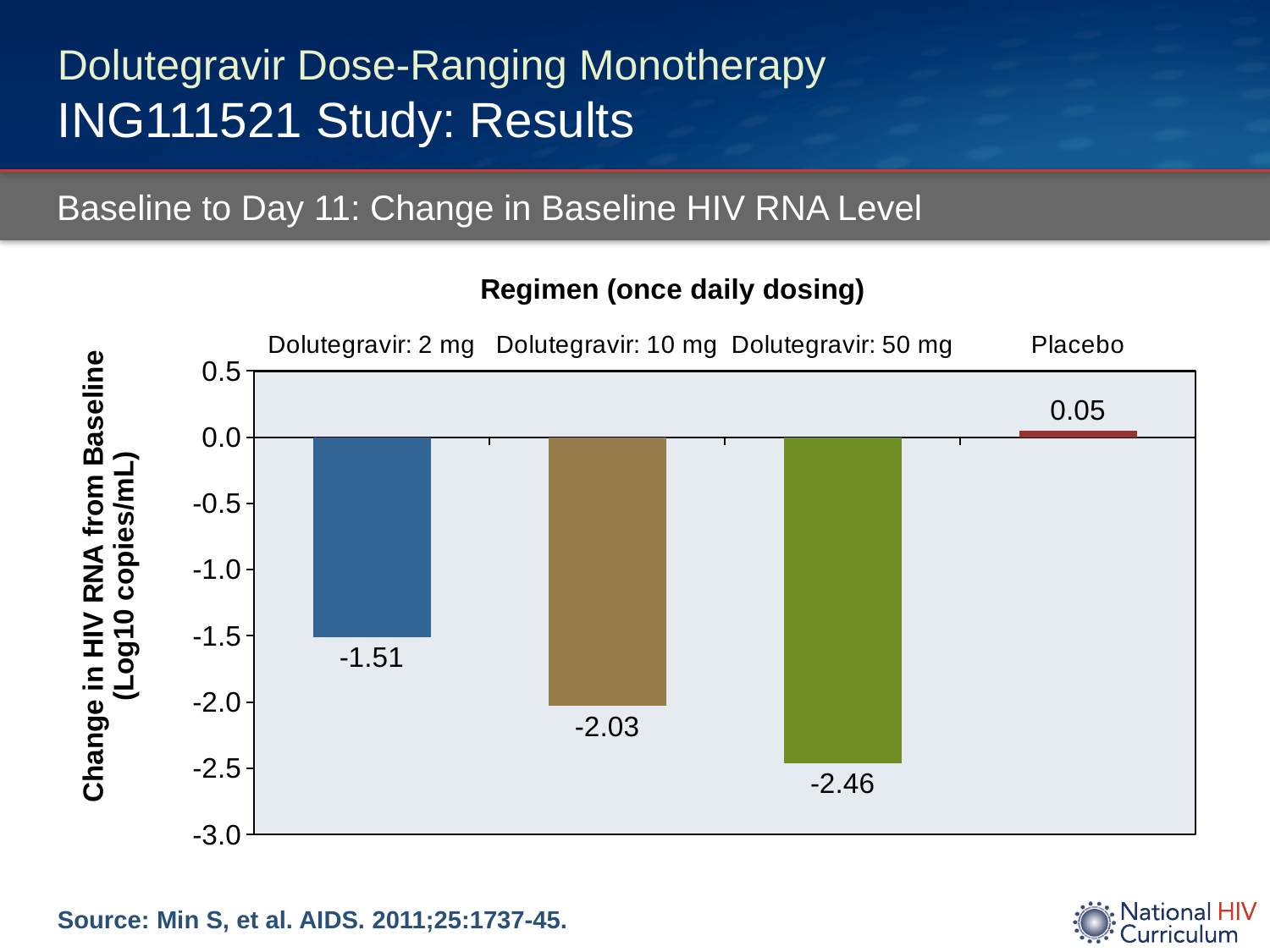
Which regimen has a greater decrease in HIV RNA, Dolutegravir: 10 mg or Dolutegravir: 50 mg? Dolutegravir: 50 mg What is the label of the vertical axis? Change in HIV RNA from Baseline (Log10 copies/mL) How many regimens are shown on the chart? 4 What is the change in HIV RNA from baseline for Dolutegravir: 10 mg? -2.03 What is the difference between the values for Dolutegravir: 10 mg and Dolutegravir: 2 mg? 0.52 Which regimen shows the largest decrease in HIV RNA from baseline? Dolutegravir: 50 mg What is the change in HIV RNA from baseline for Placebo? 0.05 What is the change in HIV RNA from baseline for Dolutegravir: 50 mg? -2.46 Which regimen has the highest value on the chart? Placebo What is the change in HIV RNA from baseline for Dolutegravir: 2 mg? -1.51 What kind of chart is shown on the slide? Bar chart What is the difference between the values for Dolutegravir: 50 mg and Dolutegravir: 2 mg? 0.95